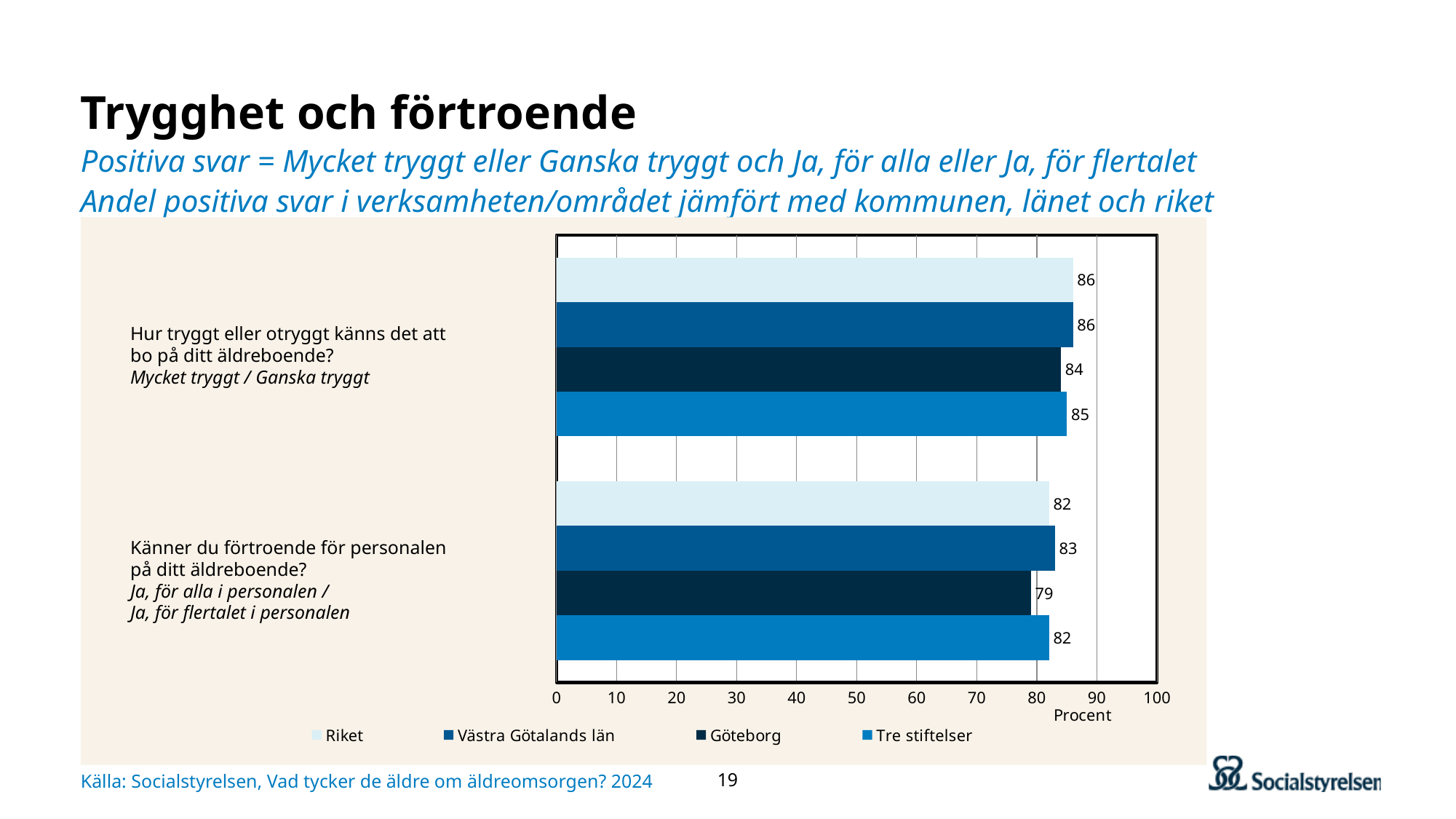
What is the value for Västra Götalands län on the question "Känner du förtroende för personalen på ditt äldreboende?"? 83 What is the difference between the Västra Götalands län value and the Göteborg value on the question "Känner du förtroende för personalen på ditt äldreboende?"? 4 What is the difference between the Tre stiftelser value for "Hur tryggt eller otryggt känns det att bo på ditt äldreboende?" and the Tre stiftelser value for "Känner du förtroende för personalen på ditt äldreboende?"? 3 Which series has the lowest value on the question "Känner du förtroende för personalen på ditt äldreboende?"? Göteborg What unit is shown on the x axis of the chart? Procent What kind of chart is shown on the slide? bar chart Which is larger: the Göteborg value for "Hur tryggt eller otryggt känns det att bo på ditt äldreboende?" or the Göteborg value for "Känner du förtroende för personalen på ditt äldreboende?"? Hur tryggt eller otryggt känns det att bo på ditt äldreboende? What is the value for Göteborg on the question "Känner du förtroende för personalen på ditt äldreboende?"? 79 What is the value for Riket on the question "Hur tryggt eller otryggt känns det att bo på ditt äldreboende?"? 86 How many series does the legend list? 4 What is the value for Tre stiftelser on the question "Hur tryggt eller otryggt känns det att bo på ditt äldreboende?"? 85 Which series has the lowest value on the question "Hur tryggt eller otryggt känns det att bo på ditt äldreboende?"? Göteborg